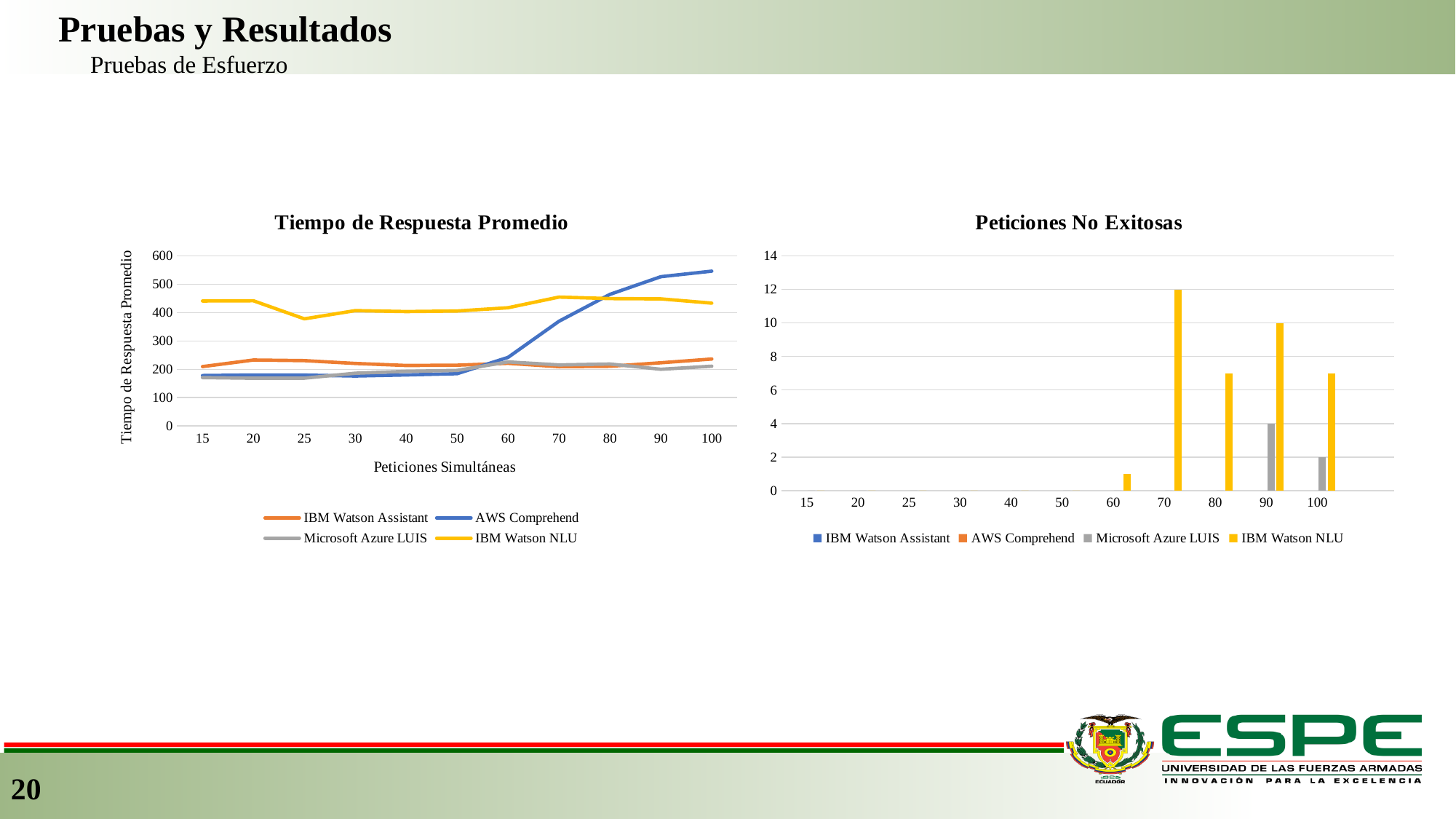
How many series does the legend of the 'Tiempo de Respuesta Promedio' chart list? 4 How many categories are shown on the x axis of the 'Peticiones No Exitosas' chart? 11 In the 'Tiempo de Respuesta Promedio' chart, is the value for AWS Comprehend at 100 greater or less than 500? greater What kind of chart is the 'Peticiones No Exitosas' chart? bar chart What kind of chart is the 'Tiempo de Respuesta Promedio' chart? line chart In the 'Tiempo de Respuesta Promedio' chart, is the value for IBM Watson NLU at 25 greater or less than 400? less In the 'Peticiones No Exitosas' chart, which is larger at 90: IBM Watson NLU or Microsoft Azure LUIS? IBM Watson NLU In the 'Peticiones No Exitosas' chart, at which x-axis category does IBM Watson NLU reach its highest value? 70 In the 'Peticiones No Exitosas' chart, what is the value for Microsoft Azure LUIS at 100? 2 In the 'Peticiones No Exitosas' chart, what is the value for IBM Watson NLU at 70 simultaneous requests? 12 In the 'Peticiones No Exitosas' chart, what is the value for Microsoft Azure LUIS at 90? 4 In the 'Tiempo de Respuesta Promedio' chart, does the AWS Comprehend line rise or fall from 50 to 100 simultaneous requests? rise